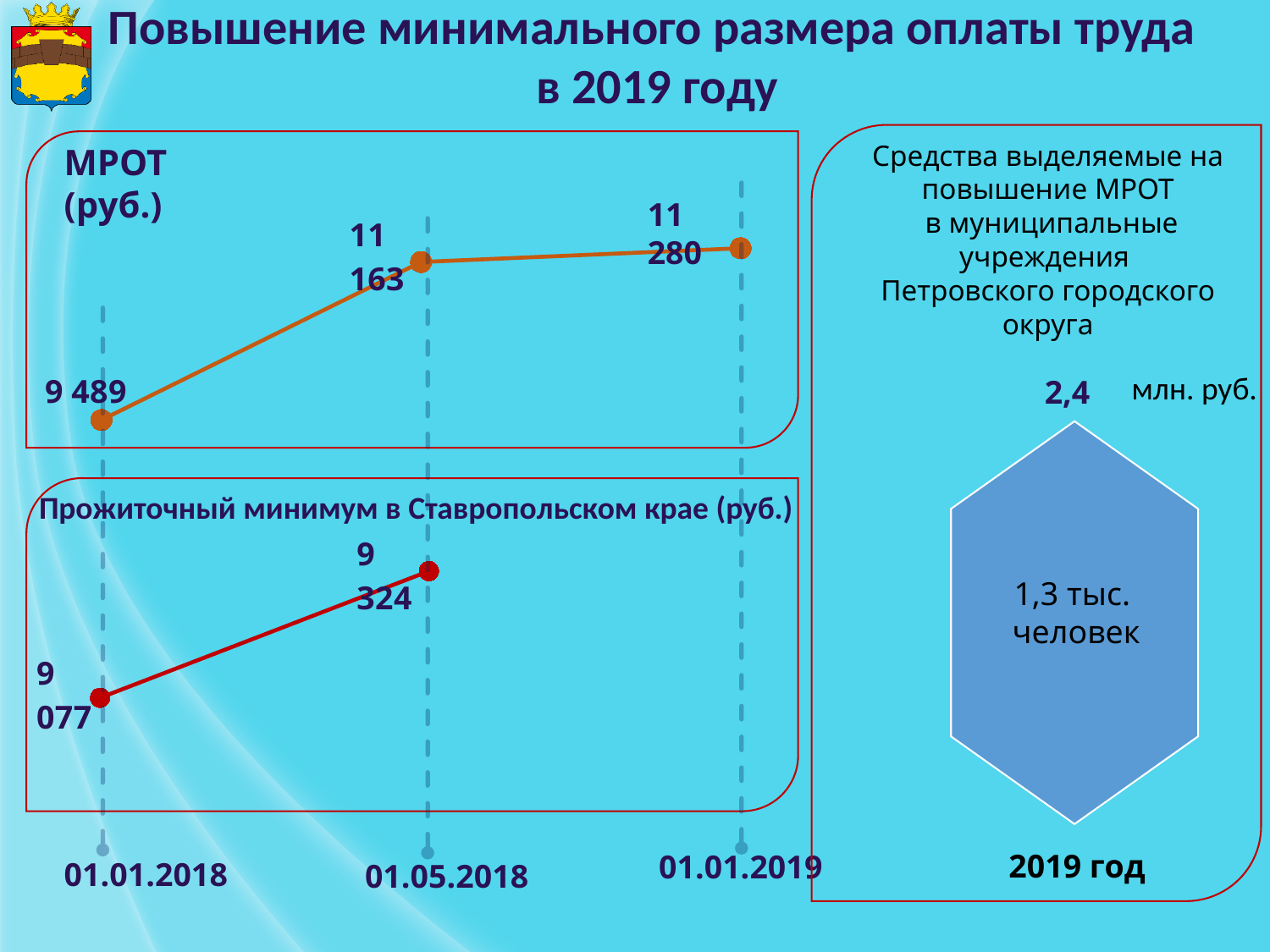
On the МРОТ (руб.) chart, how many data points are plotted? 3 On the Прожиточный минимум в Ставропольском крае (руб.) chart, what is the difference between the values for 01.05.2018 and 01.01.2018? 247 What kind of chart is the МРОТ (руб.) chart? line chart On the МРОТ (руб.) chart, which date has the lowest value? 01.01.2018 On the МРОТ (руб.) chart, what is the value for 01.05.2018? 11 163 On the МРОТ (руб.) chart, which date has the highest value? 01.01.2019 On the Прожиточный минимум в Ставропольском крае (руб.) chart, what is the value for 01.01.2018? 9 077 On the Прожиточный минимум в Ставропольском крае (руб.) chart, what is the value for 01.05.2018? 9 324 On the МРОТ (руб.) chart, what is the value for 01.01.2018? 9 489 On the МРОТ (руб.) chart, what is the difference between the values for 01.05.2018 and 01.01.2018? 1 674 On the МРОТ (руб.) chart, what is the value for 01.01.2019? 11 280 On the МРОТ (руб.) chart, do the values rise or fall from 01.01.2018 to 01.01.2019? rise